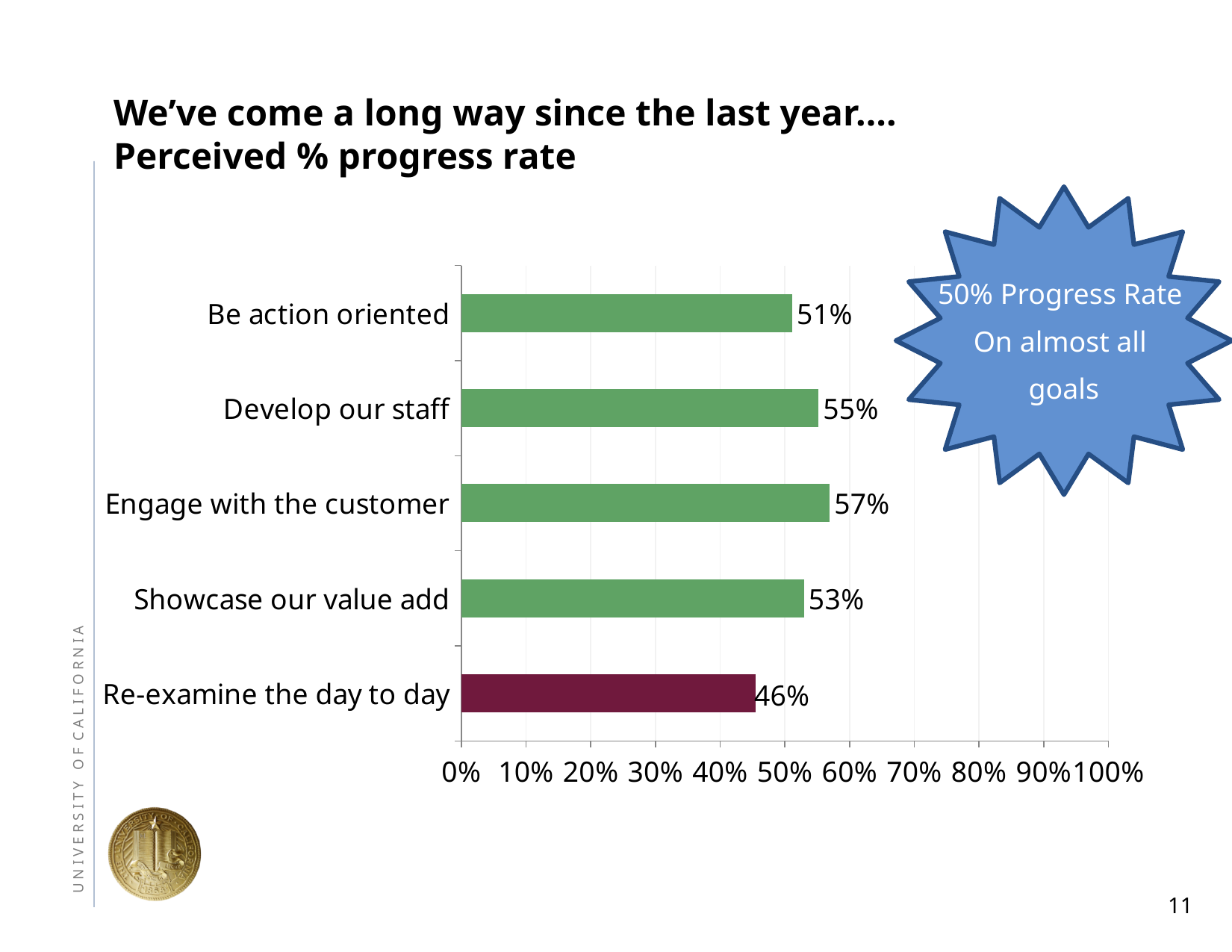
What is the perceived progress rate for 'Re-examine the day to day'? 46% Which bar is shown in a different colour from the others? Re-examine the day to day What is the difference between the progress rates for 'Develop our staff' and 'Showcase our value add'? 2% How many categories are shown in the chart? 5 Which category has the highest perceived progress rate? Engage with the customer What is the perceived progress rate for 'Be action oriented'? 51% What is the difference between the progress rates for 'Engage with the customer' and 'Re-examine the day to day'? 11% What kind of chart is shown on the slide? Bar chart Which category has the lowest perceived progress rate? Re-examine the day to day What is the perceived progress rate for 'Develop our staff'? 55% Is the value for 'Re-examine the day to day' greater or less than 50%? less Which has a higher progress rate, 'Showcase our value add' or 'Be action oriented'? Showcase our value add